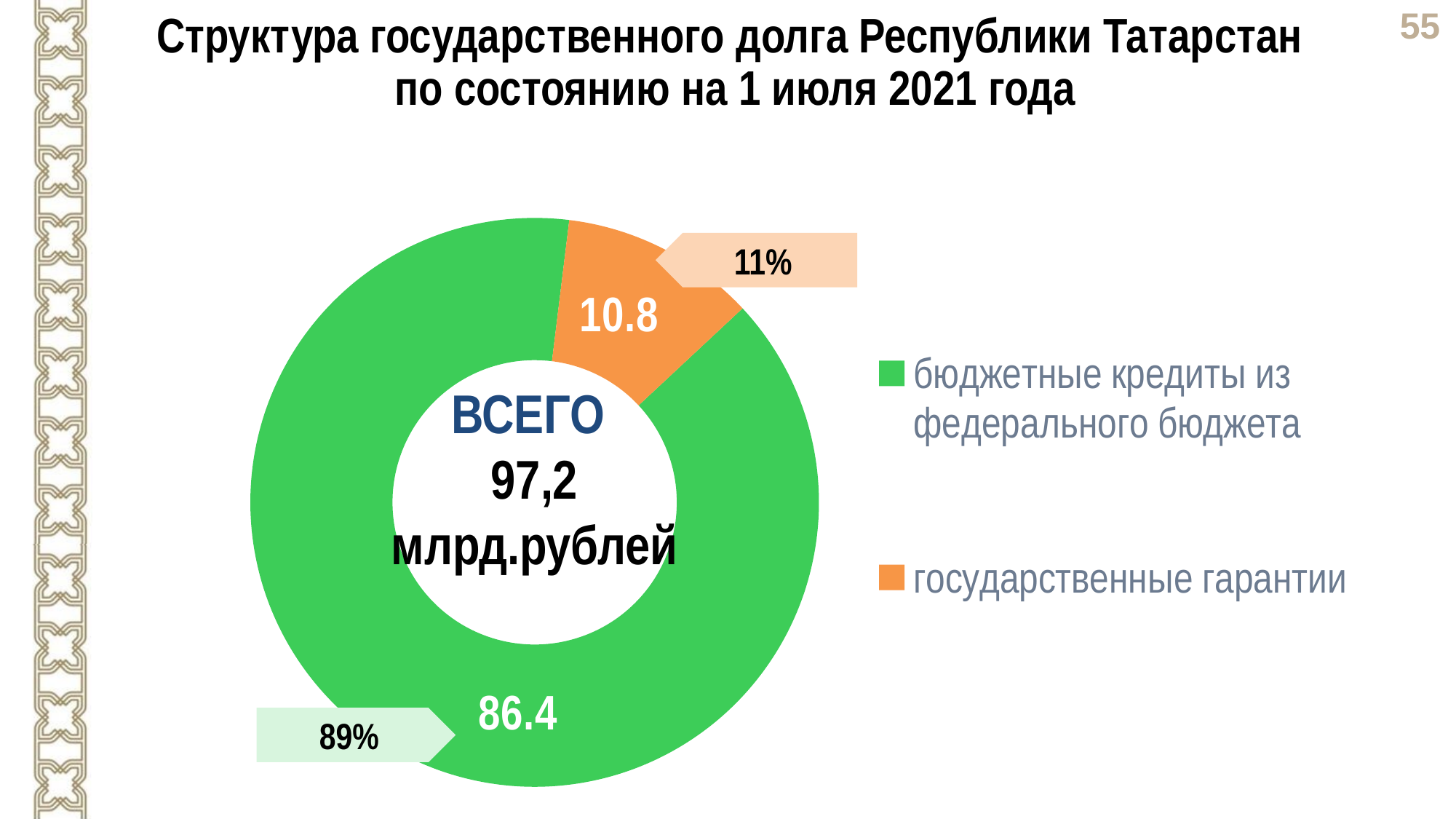
What total value is shown in the centre of the chart? 97,2 млрд.рублей What percentage share does государственные гарантии have? 11% Which is larger: бюджетные кредиты из федерального бюджета or государственные гарантии? бюджетные кредиты из федерального бюджета What is the value shown for бюджетные кредиты из федерального бюджета? 86.4 Which category has the largest share of the chart? бюджетные кредиты из федерального бюджета Which category has the smallest share of the chart? государственные гарантии What percentage share does бюджетные кредиты из федерального бюджета have? 89% What colour represents государственные гарантии in the chart? orange What is the difference between the values for бюджетные кредиты из федерального бюджета and государственные гарантии? 75.6 What kind of chart is shown on the slide? pie chart (doughnut) What is the value shown for государственные гарантии? 10.8 How many categories does the chart show? 2